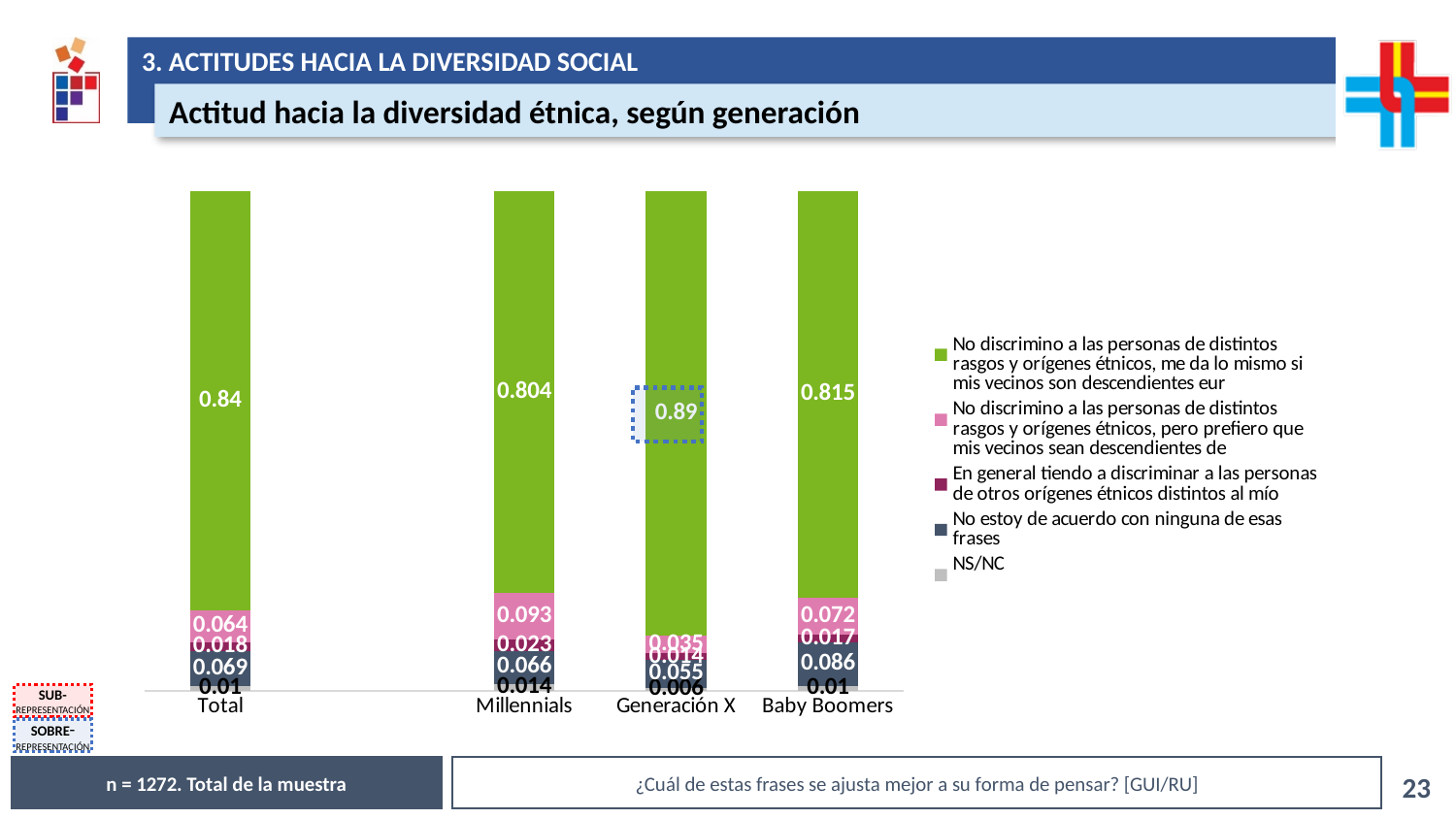
What is the value for Millennials in the series 'En general tiendo a discriminar a las personas de otros orígenes étnicos distintos al mío'? 0.023 What is the difference between Baby Boomers and Millennials in the series 'No estoy de acuerdo con ninguna de esas frases'? 0.02 What kind of chart is shown on the slide? Stacked bar chart How many series does the legend list? 5 What is the value for Baby Boomers in the series 'No estoy de acuerdo con ninguna de esas frases'? 0.086 Which category has the lowest NS/NC value? Generación X What is the NS/NC value for the Total category? 0.01 What is the difference between Millennials and Baby Boomers in the series 'No discrimino a las personas de distintos rasgos y orígenes étnicos, pero prefiero que mis vecinos sean descendientes de'? 0.021 How many categories are shown on the x axis of the chart? 4 What is the value for Millennials in the series 'No discrimino a las personas de distintos rasgos y orígenes étnicos, me da lo mismo si mis vecinos son descendientes eur'? 0.804 Which is larger for 'No discrimino a las personas de distintos rasgos y orígenes étnicos, me da lo mismo si mis vecinos son descendientes eur': Total or Baby Boomers? Total Which category has the highest value for 'No discrimino a las personas de distintos rasgos y orígenes étnicos, me da lo mismo si mis vecinos son descendientes eur'? Generación X